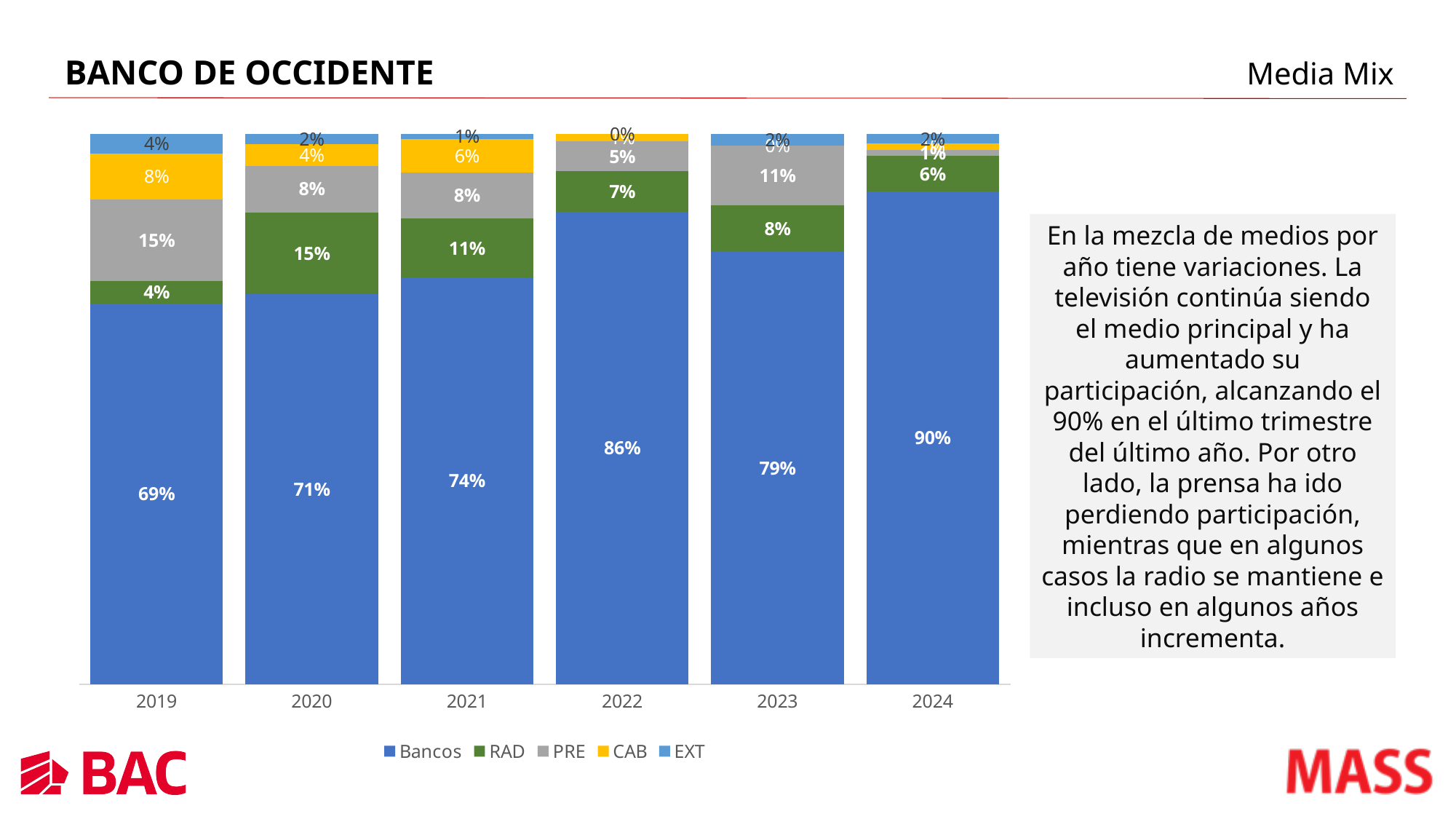
What is the CAB share in 2021? 6% What is the Bancos share in 2024? 90% How many series does the legend list? 5 What is the Bancos share in 2019? 69% What is the PRE share in 2023? 11% What is the difference between the Bancos share in 2022 and in 2021? 12% In which year is the Bancos share lowest? 2019 What kind of chart is shown on the slide? stacked bar chart What is the RAD share in 2020? 15% Which is larger in 2019, the PRE share or the CAB share? PRE How many years are shown on the x axis? 6 In which year is the Bancos share highest? 2024